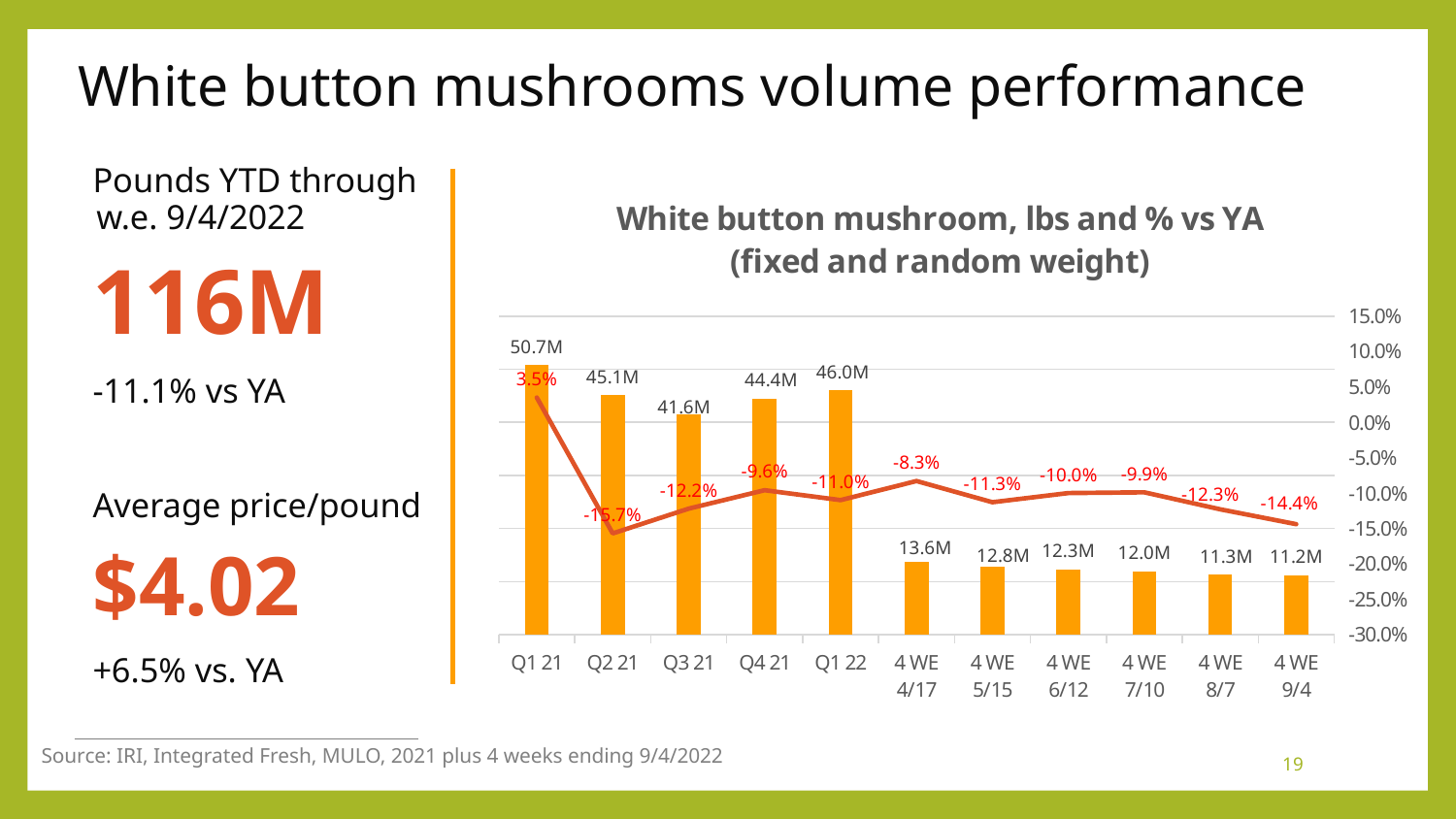
How many categories are shown on the x axis? 11 Which category has the lowest % vs YA value on the line? Q2 21 What is the % vs YA value for the 4 WE 9/4 period? -14.4% What is the title of the chart? White button mushroom, lbs and % vs YA (fixed and random weight) What kind of chart is shown on the slide? Combined bar and line chart What is the volume in pounds for Q1 21? 50.7M Which is larger, the volume for Q2 21 or Q3 21? Q2 21 Which category has the highest volume in pounds? Q1 21 Which category has the lowest volume in pounds? 4 WE 9/4 Do the bar values rise or fall from the 4 WE 4/17 period to the 4 WE 9/4 period? Fall What is the volume in pounds for the 4 WE 6/12 period? 12.3M What is the difference in pounds between Q1 22 and Q4 21? 1.6M